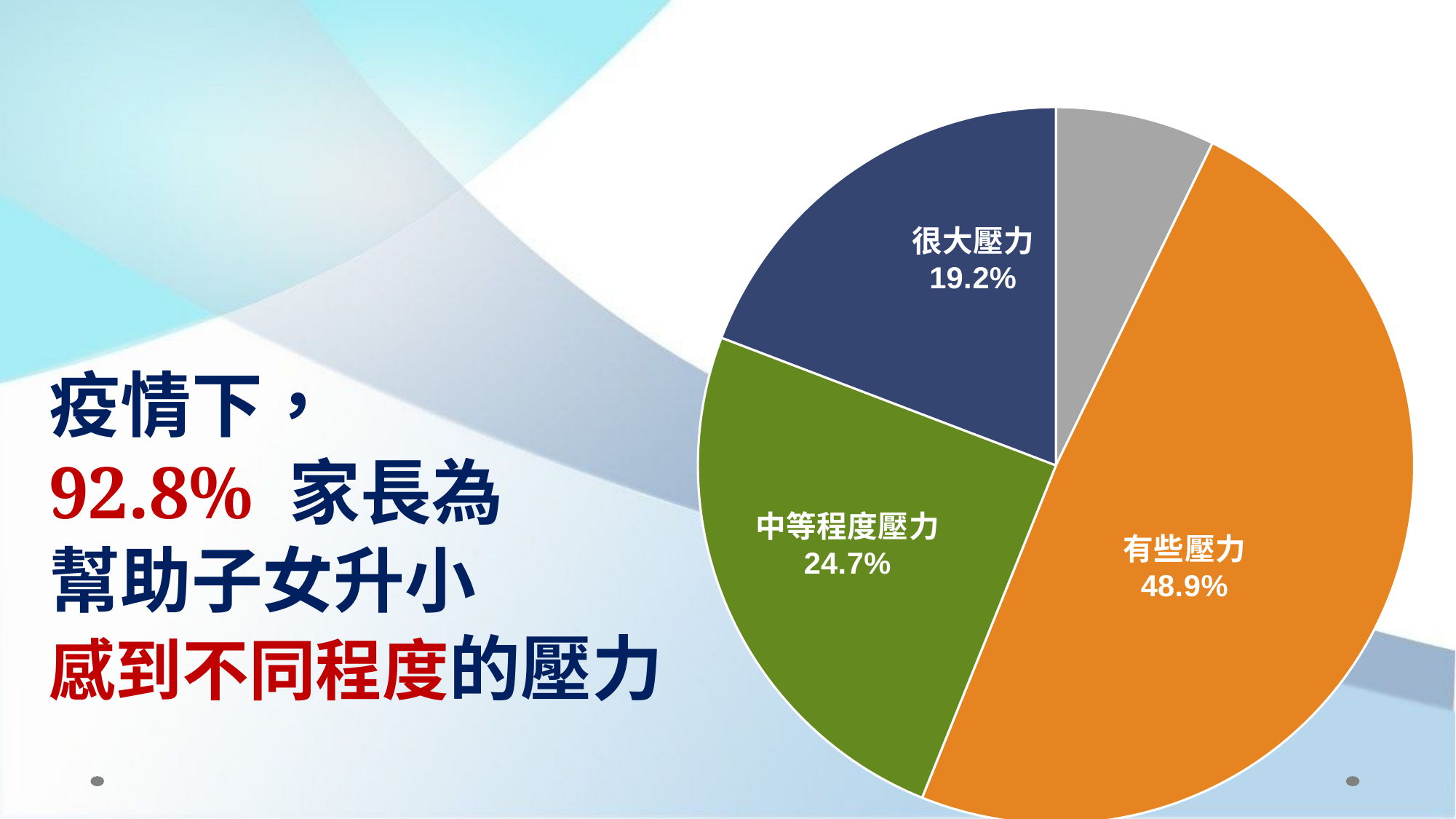
What kind of chart is shown on the slide? pie chart Which is larger, the share for 中等程度壓力 or the share for 很大壓力? 中等程度壓力 What is the difference in percentage points between 有些壓力 and 中等程度壓力? 24.2 What percentage is shown for 中等程度壓力? 24.7% Which slice of the pie chart is the largest? 有些壓力 What is the difference in percentage points between 中等程度壓力 and 很大壓力? 5.5 What percentage is shown for 有些壓力? 48.9% What is the combined share of the three labelled slices (有些壓力, 中等程度壓力, 很大壓力)? 92.8% What percentage is shown for 很大壓力? 19.2% How many slices does the pie chart have? 4 Among the three labelled slices, which has the smallest share? 很大壓力 What colour is the 有些壓力 slice? orange